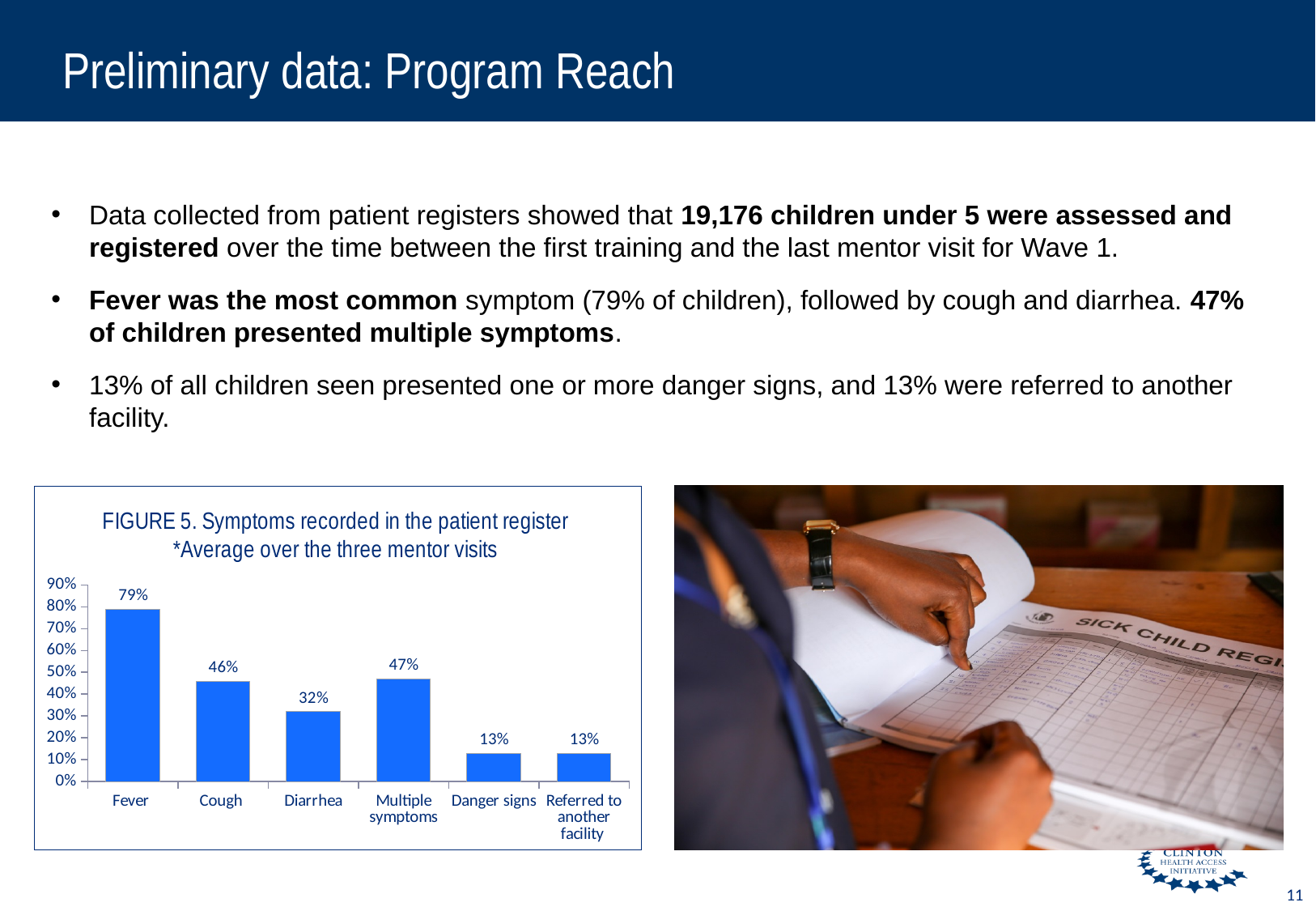
Which category has the highest value? Fever What is the value for Danger signs? 13% How many categories are shown on the x axis? 6 What is the value for Fever? 79% What is the value for Diarrhea? 32% What is the difference between the values for Fever and Cough? 33% What kind of chart is shown? bar chart What is the title of the chart? FIGURE 5. Symptoms recorded in the patient register *Average over the three mentor visits What is the value for Multiple symptoms? 47% Which is larger, the value for Diarrhea or the value for Multiple symptoms? Multiple symptoms Is the value for Diarrhea greater or less than 40%? less What is the value for Cough? 46%